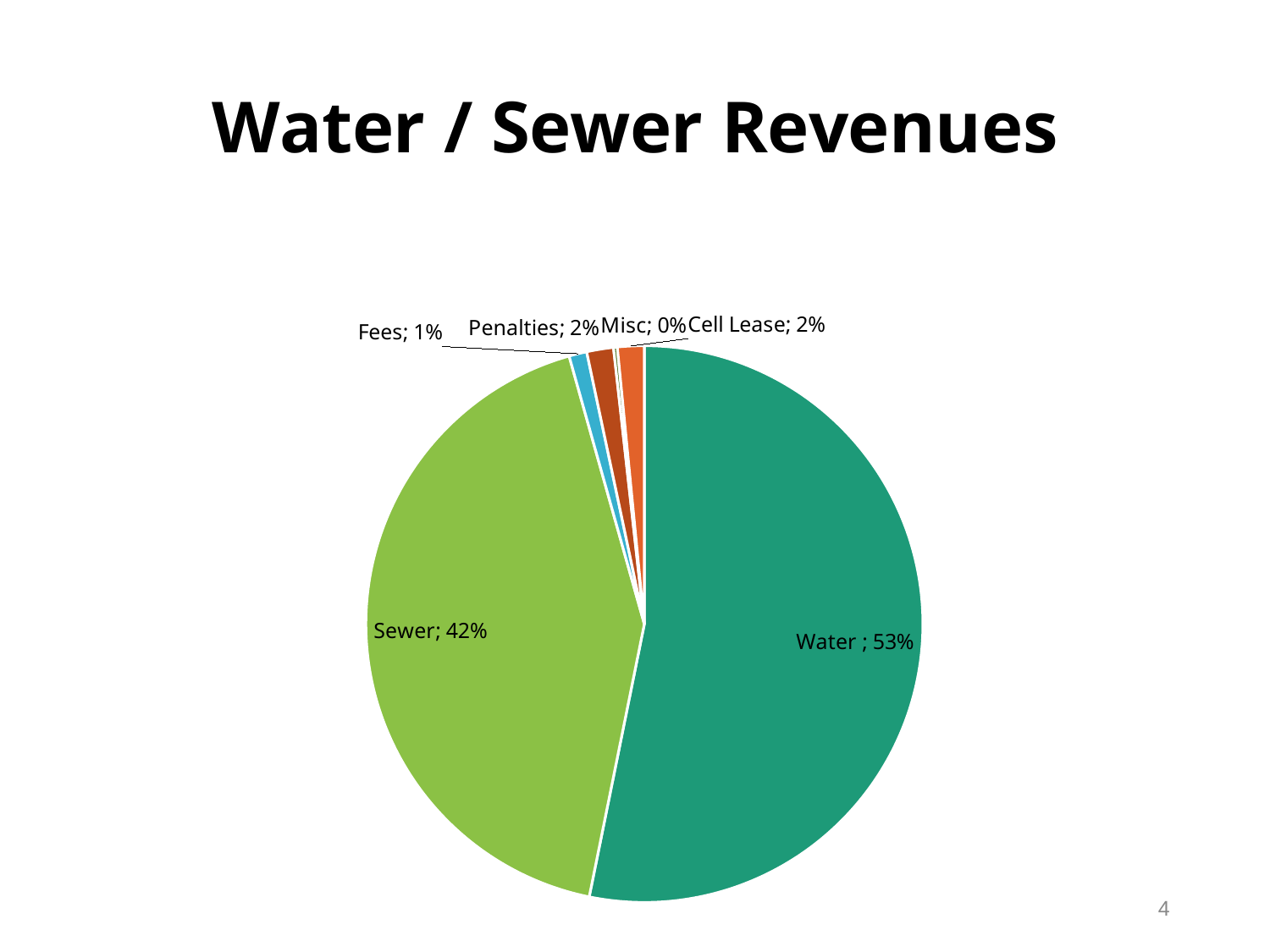
What share of Water / Sewer Revenues comes from Sewer? 42% Which category has the smallest share of the pie? Misc Which is larger, the Sewer share or the Fees share? Sewer What percentage is shown for Cell Lease? 2% What type of chart is shown on the slide? Pie chart What share of Water / Sewer Revenues comes from Water? 53% What percentage is shown for Fees? 1% How many categories are shown in the pie chart? 6 What percentage is shown for Misc? 0% What is the difference in percentage points between Water and Sewer? 11 What percentage is shown for Penalties? 2% Which category has the largest share of the pie? Water